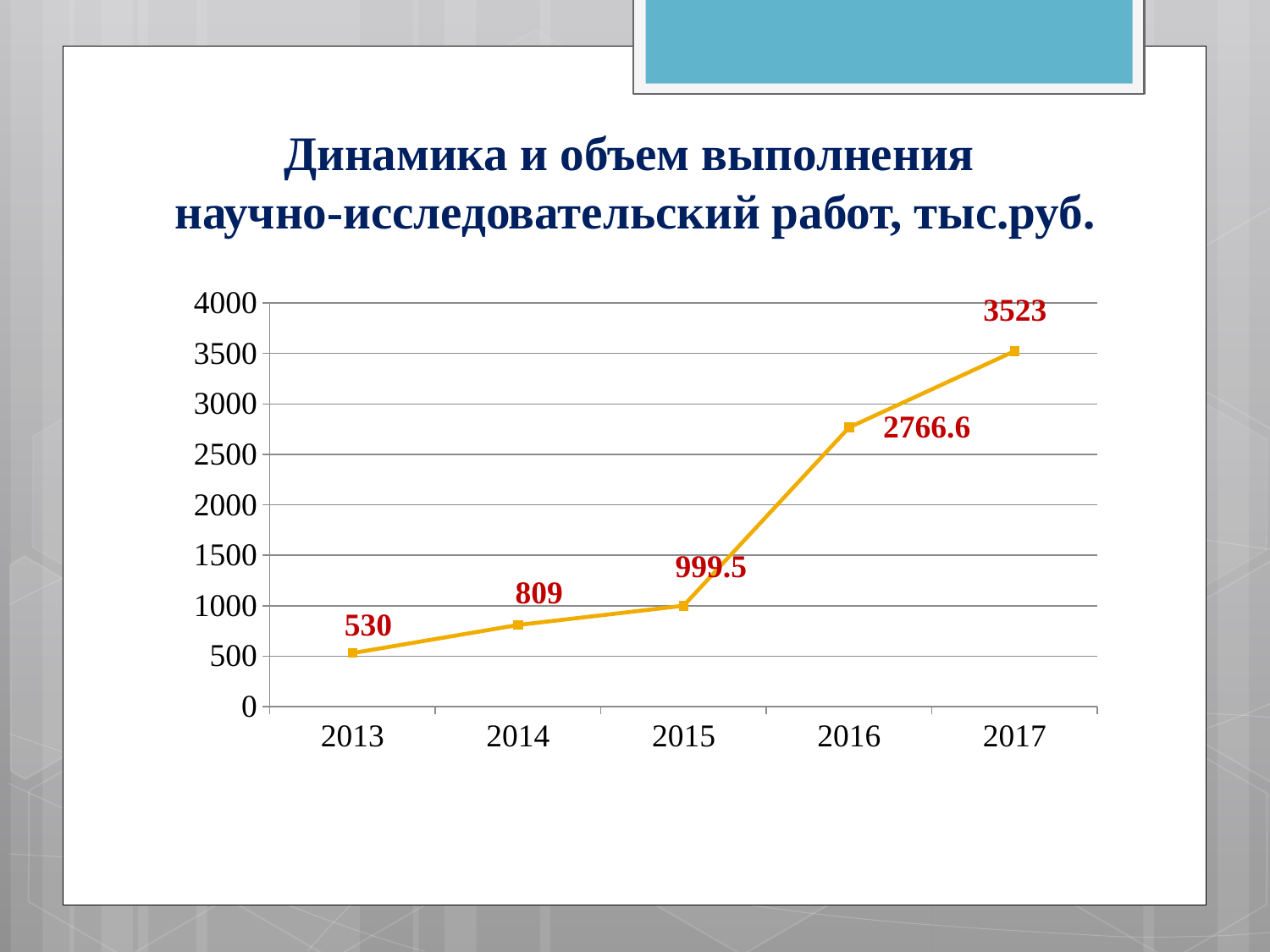
What is the value for 2017? 3523 What is the difference between the values for 2014 and 2013? 279 Which is larger, the value for 2015 or the value for 2014? 2015 Which year has the highest value? 2017 What is the difference between the values for 2017 and 2016? 756.4 What is the value for 2013? 530 Do the values rise or fall from 2013 to 2017? rise What is the value for 2015? 999.5 What is the value for 2016? 2766.6 Which year has the lowest value? 2013 How many years are plotted on the chart? 5 What kind of chart is shown on the slide? line chart